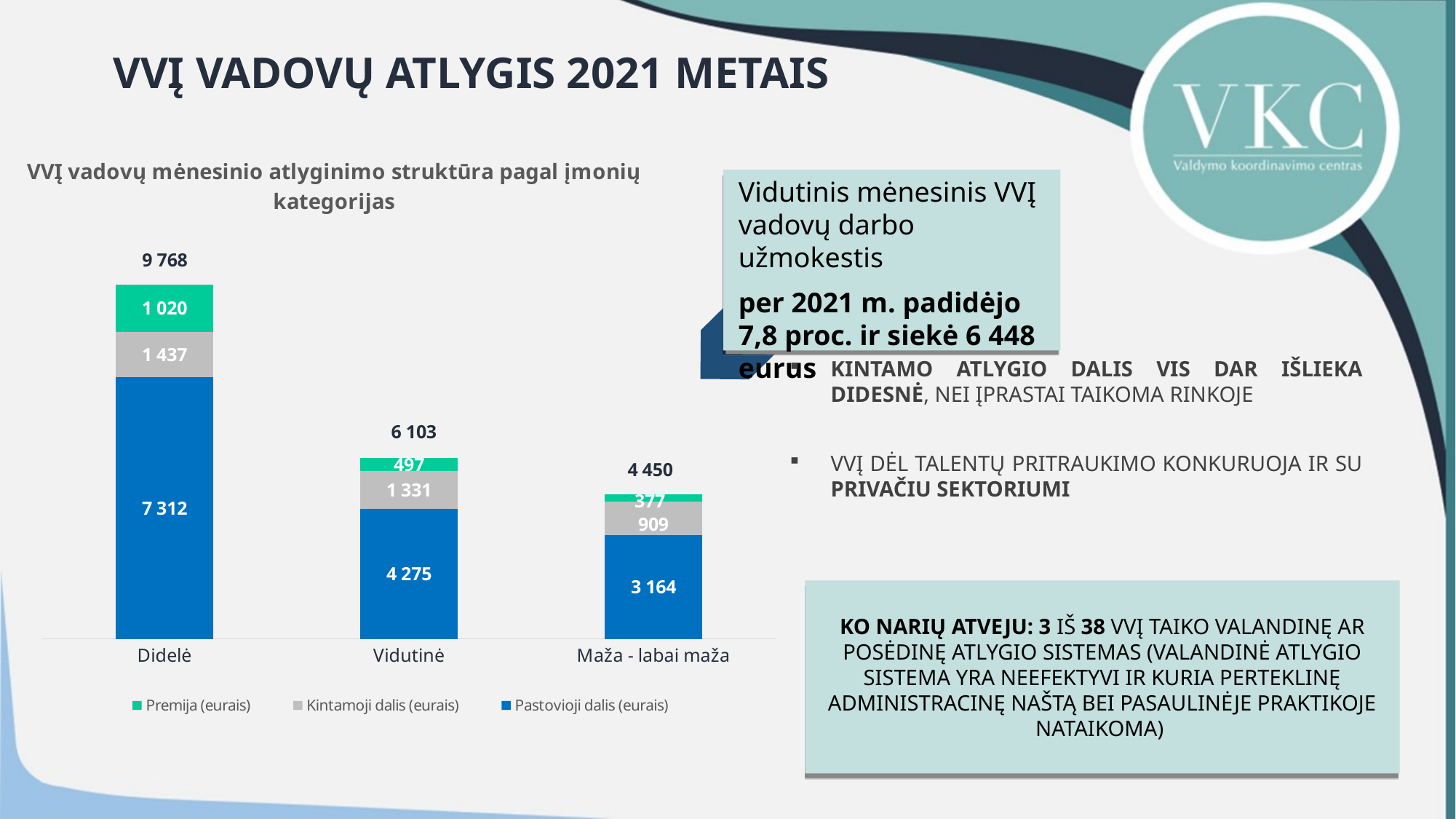
How many series does the legend list? 3 Do the total values rise or fall from Didelė to Maža - labai maža along the x axis? Fall Which category has the lowest Pastovioji dalis (eurais) value? Maža - labai maža What type of chart is shown on the slide? Stacked bar chart What is the value of Kintamoji dalis (eurais) for Vidutinė? 1 331 Which category has the highest total monthly pay? Didelė What is the total of the stacked bar for Vidutinė? 6 103 What is the difference between the totals for Didelė and Maža - labai maža? 5 318 What is the value of Premija (eurais) for Maža - labai maža? 377 What is the value of Pastovioji dalis (eurais) for Didelė? 7 312 Which is larger: Premija (eurais) for Didelė or Kintamoji dalis (eurais) for Maža - labai maža? Premija (eurais) for Didelė How many company categories are shown on the x axis? 3